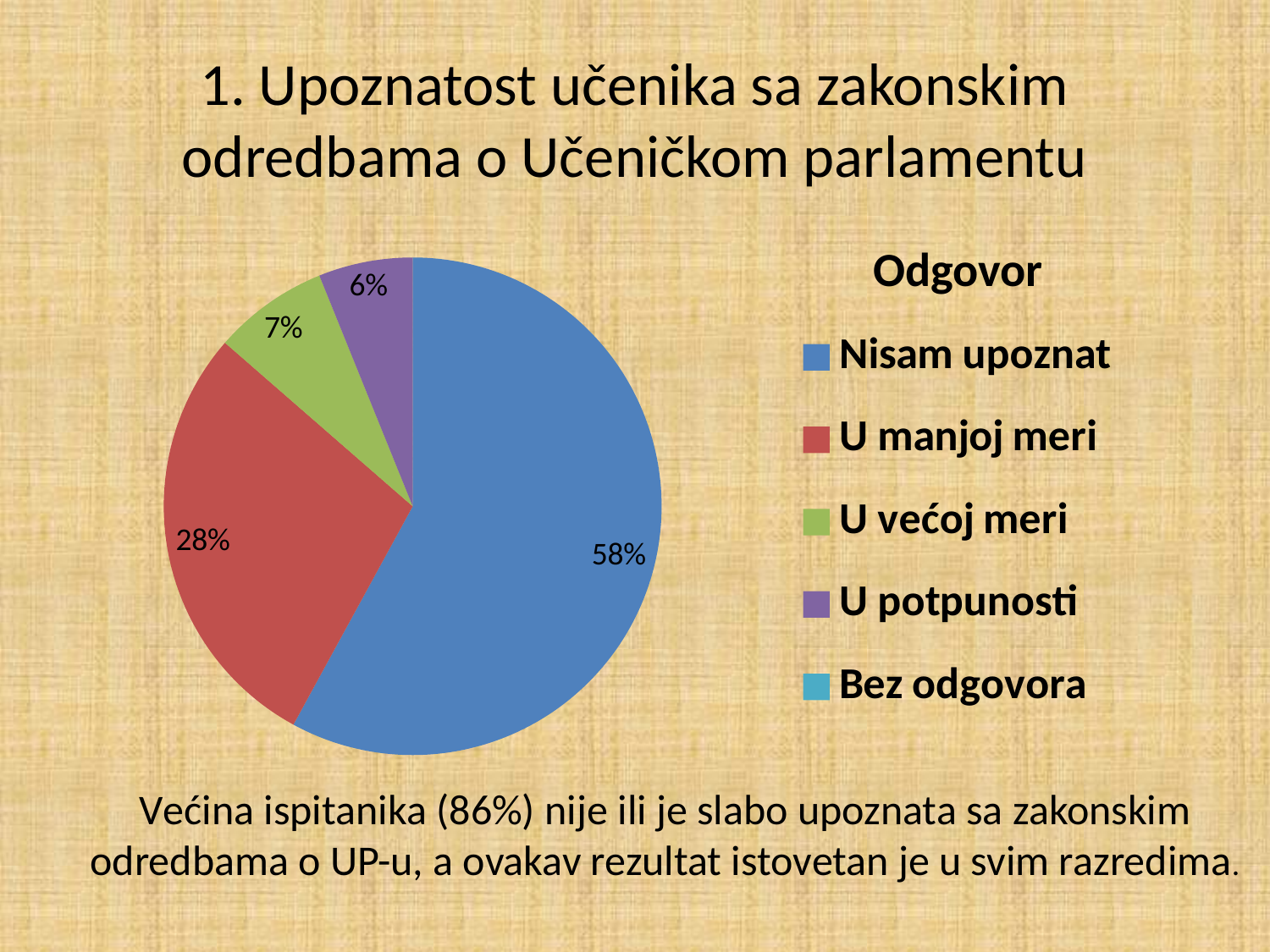
Which category has the largest slice of the pie chart? Nisam upoznat What is the value shown for "U većoj meri"? 7% How many entries does the chart legend list? 5 What is the difference in percentage points between "Nisam upoznat" and "U manjoj meri"? 30 What percentage does the "U manjoj meri" slice show? 28% What colour is the "Nisam upoznat" slice? Blue What is the title shown above the chart legend? Odgovor What percentage of the pie chart is labelled "Nisam upoznat"? 58% What type of chart is shown on the slide? Pie chart Which slice is larger, "U manjoj meri" or "U većoj meri"? U manjoj meri What is the value shown for "U potpunosti"? 6% What is the combined share of "Nisam upoznat" and "U manjoj meri"? 86%